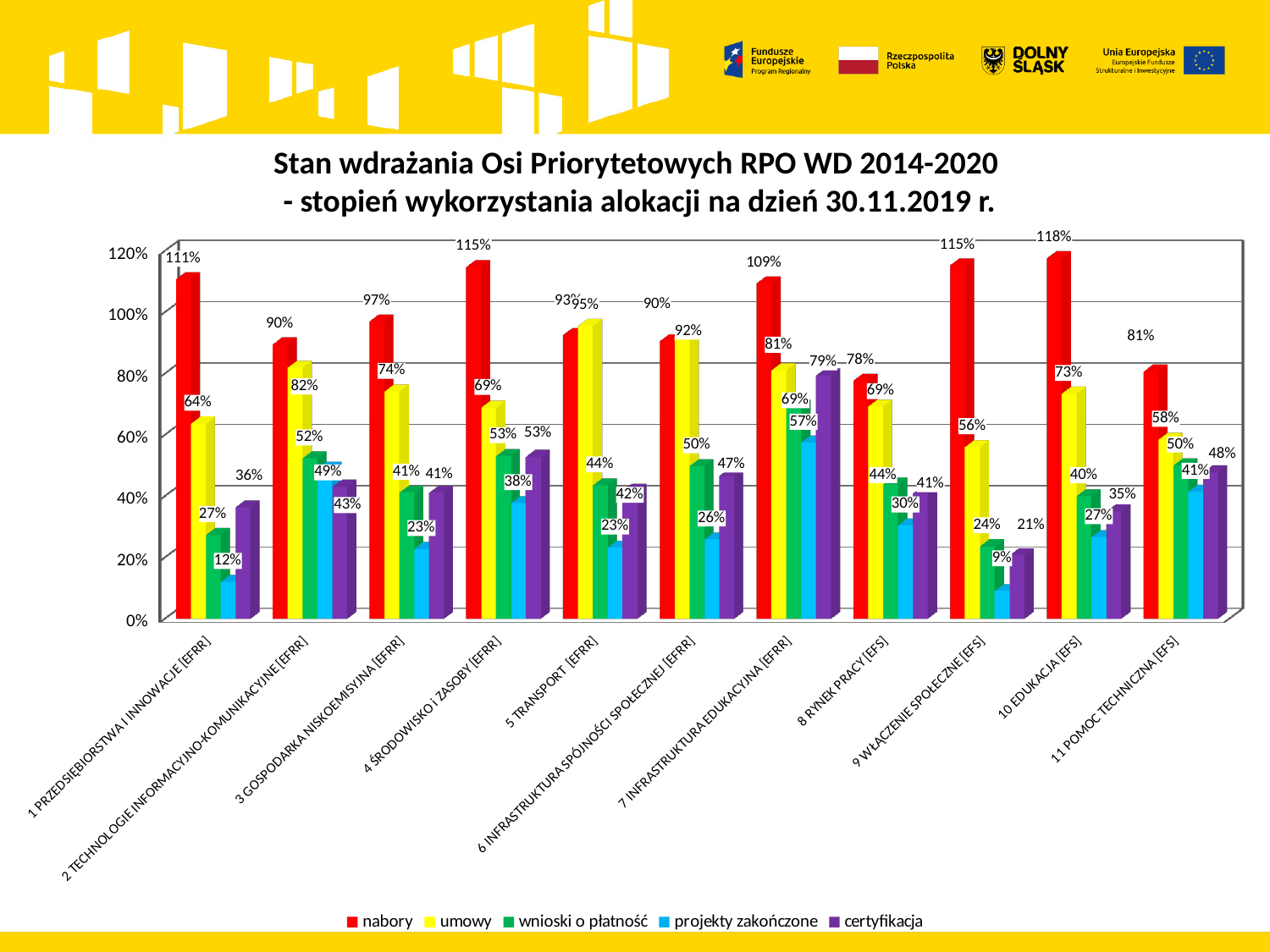
What is the value of 'certyfikacja' for 1 PRZEDSIĘBIORSTWA I INNOWACJE [EFRR]? 36% What is the difference between 'nabory' and 'umowy' for 9 WŁĄCZENIE SPOŁECZNE [EFS]? 59% Which category has the highest 'nabory' value? 10 EDUKACJA [EFS] How many series does the legend list? 5 Is the 'umowy' value for 2 TECHNOLOGIE INFORMACYJNO-KOMUNIKACYJNE [EFRR] greater or less than 80%? greater What type of chart is shown on the slide? bar chart What is the value of 'projekty zakończone' for 7 INFRASTRUKTURA EDUKACYJNA [EFRR]? 57% Which category has the lowest 'projekty zakończone' value? 9 WŁĄCZENIE SPOŁECZNE [EFS] What is the value of 'nabory' for 10 EDUKACJA [EFS]? 118% Which series is shown in red in the legend? nabory How many priority axes (categories) are shown on the x axis? 11 Which is larger for 5 TRANSPORT [EFRR]: 'nabory' or 'umowy'? umowy